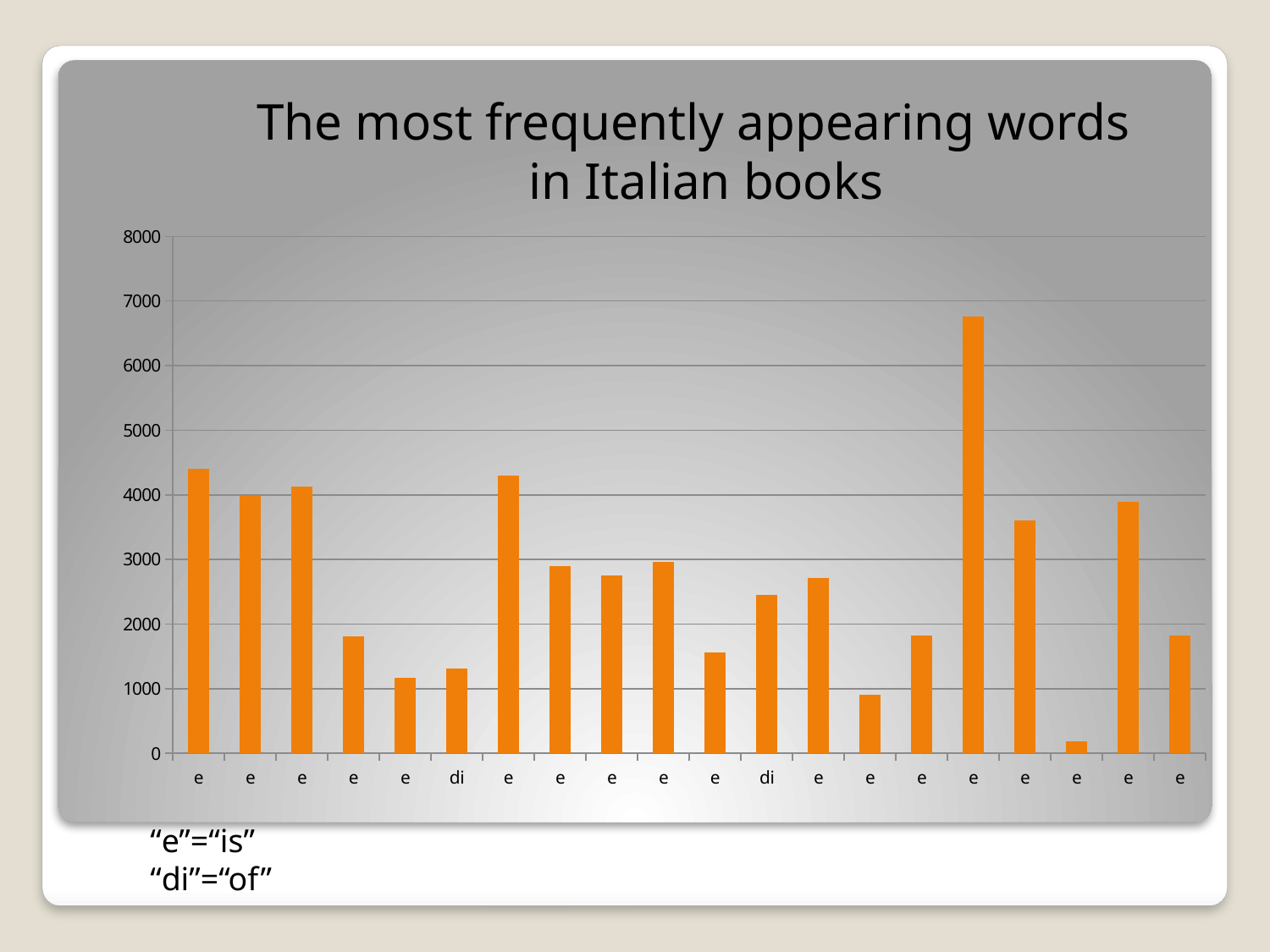
How many bars are labelled 'di'? 2 Is the value of the first 'di' bar greater or less than 2000? less Is the value of the tallest bar greater or less than 6000? greater Is the value of the first bar greater or less than 4000? greater Which bar is the shortest in the chart? the 18th bar (e) What colour are the bars in the chart? orange How many bars are plotted in the chart? 20 Which bar is the tallest in the chart? the 16th bar (e) What kind of chart is shown on the slide? bar chart What is the title of the chart? The most frequently appearing words in Italian books Which is larger, the first 'di' bar or the second 'di' bar? the second 'di' bar